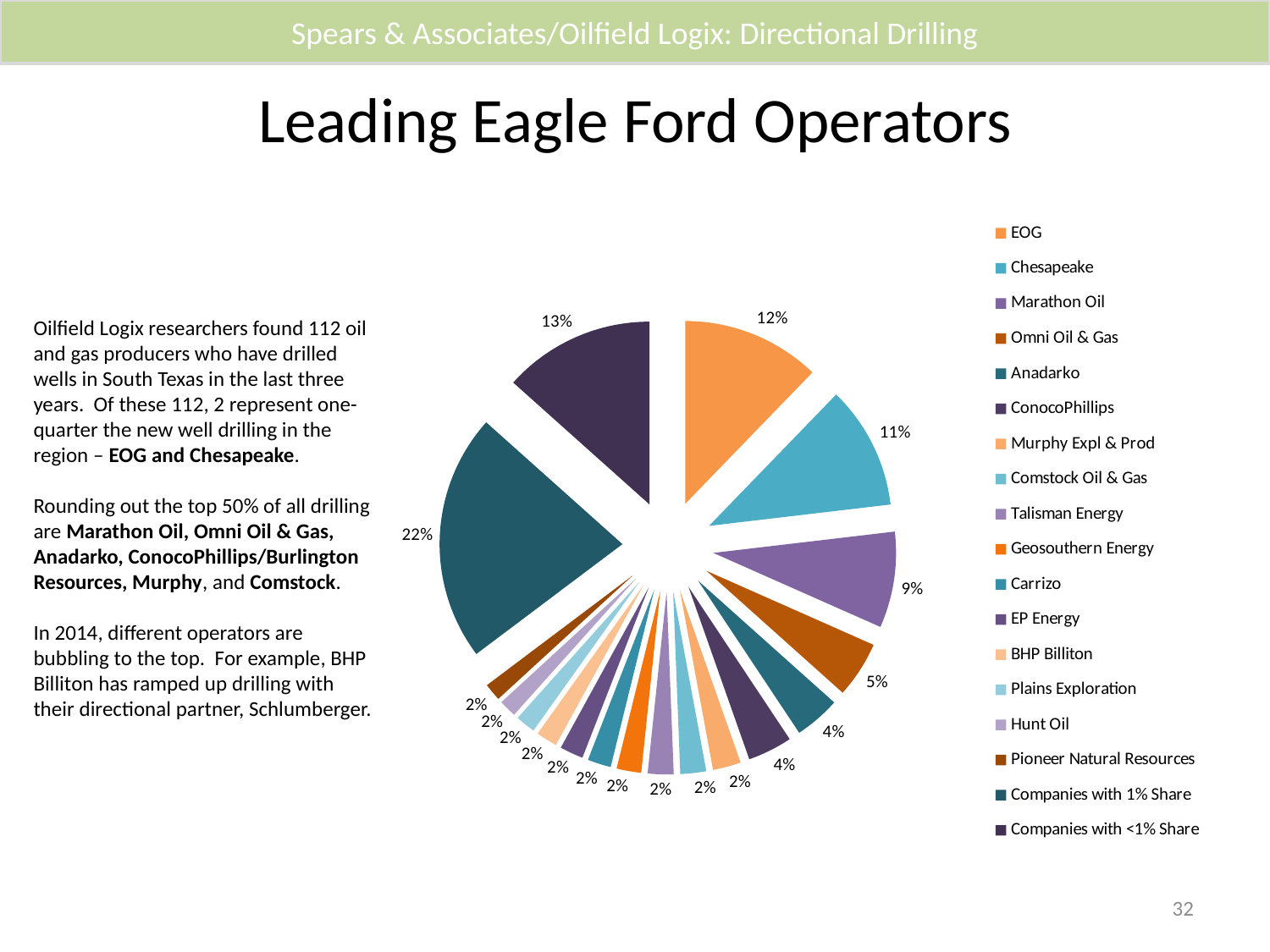
What share of the pie is labelled for Companies with <1% Share? 13% What share of the pie does Omni Oil & Gas hold? 5% Which legend entry has the largest slice of the pie? Companies with 1% Share What share of the pie does Marathon Oil hold? 9% How many entries does the chart legend list? 18 What kind of chart is shown on the slide? Pie chart What share of the pie does EOG hold? 12% What share of the pie does Chesapeake hold? 11% Which has a larger share, Marathon Oil or Omni Oil & Gas? Marathon Oil What is the difference between the EOG share and the Chesapeake share? 1% What is the title of the chart slide? Leading Eagle Ford Operators What is the combined share of EOG and Chesapeake? 23%